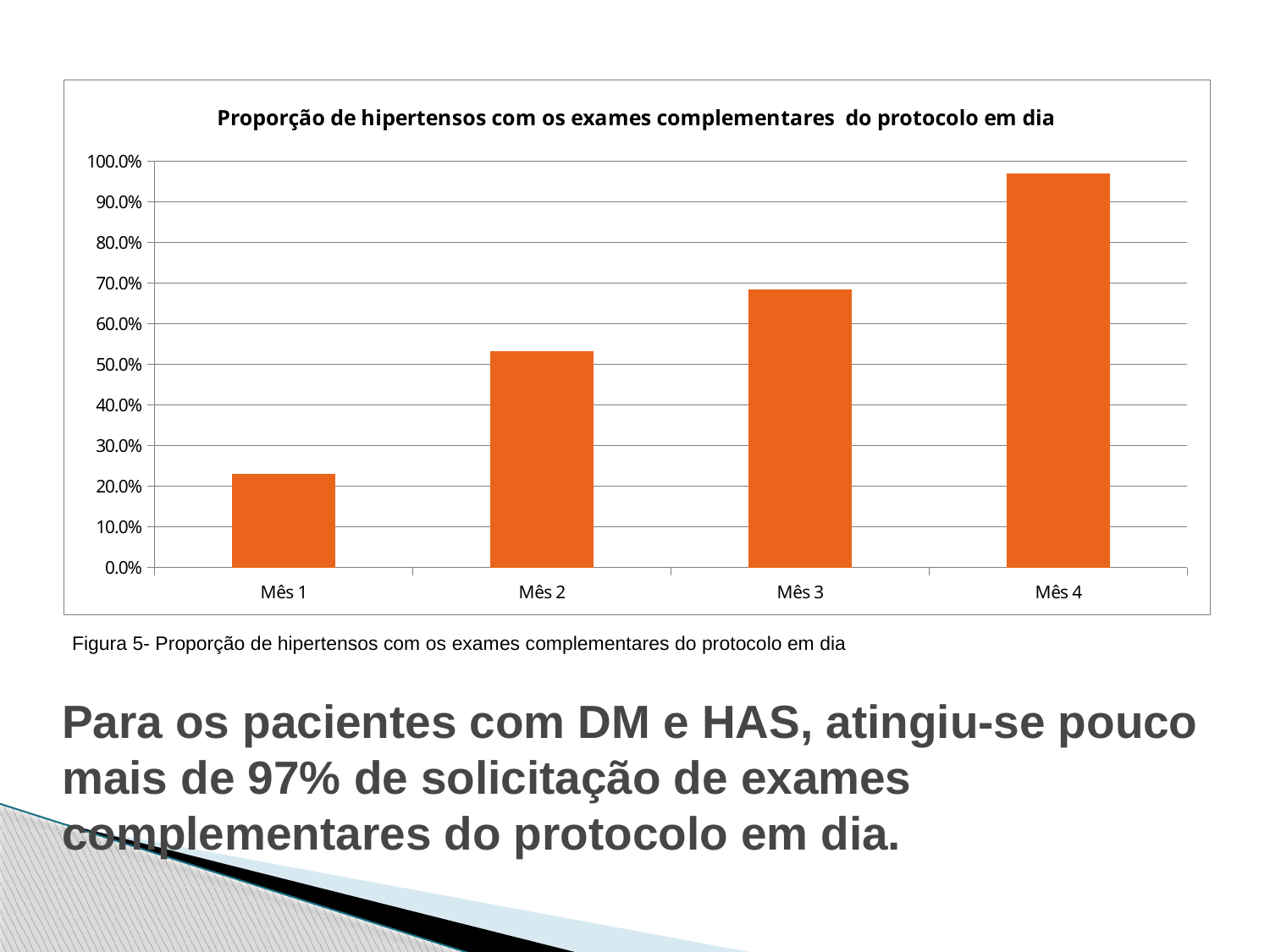
Is the value for Mês 1 greater or less than 30.0%? less What colour are the bars in the chart? orange Do the values rise or fall from Mês 1 to Mês 4? rise Is the value for Mês 2 greater or less than 50.0%? greater Which month has the highest value in the chart? Mês 4 Which is larger, the value for Mês 2 or the value for Mês 3? Mês 3 Is the value for Mês 3 greater or less than 60.0%? greater What is the title of the chart? Proporção de hipertensos com os exames complementares do protocolo em dia How many categories (months) are shown on the x axis of the chart? 4 What type of chart is shown on the slide? bar chart Which month has the lowest value in the chart? Mês 1